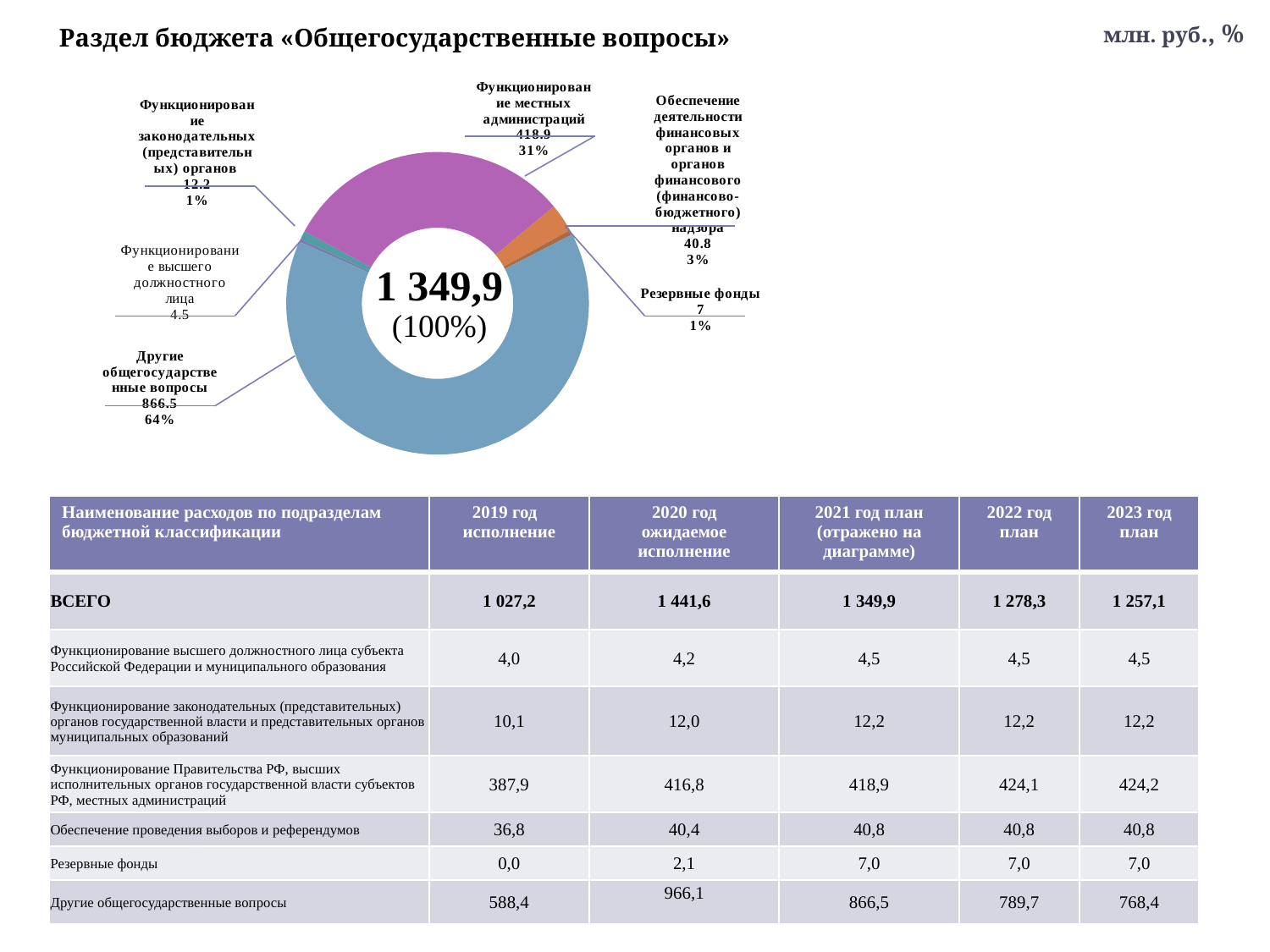
What share of the donut chart does «Функционирование местных администраций» represent? 31% Which is larger on the donut chart: «Обеспечение деятельности финансовых органов...» or «Функционирование законодательных (представительных) органов»? Обеспечение деятельности финансовых органов... Which category has the largest slice on the donut chart? Другие общегосударственные вопросы What is the difference between the values for «Другие общегосударственные вопросы» and «Функционирование местных администраций» on the donut chart? 447.6 What is the value for «Функционирование высшего должностного лица» on the donut chart? 4.5 What kind of chart is shown on the slide? Donut (pie) chart What is the value for «Резервные фонды» on the donut chart? 7 Which category has the smallest slice on the donut chart? Функционирование высшего должностного лица What total value is shown in the centre of the donut chart? 1 349,9 (100%) What is the value for «Другие общегосударственные вопросы» on the donut chart? 866.5 What is the value for «Функционирование местных администраций» on the donut chart? 418.9 What share of the donut chart does «Обеспечение деятельности финансовых органов и органов финансового (финансово-бюджетного) надзора» represent? 3%